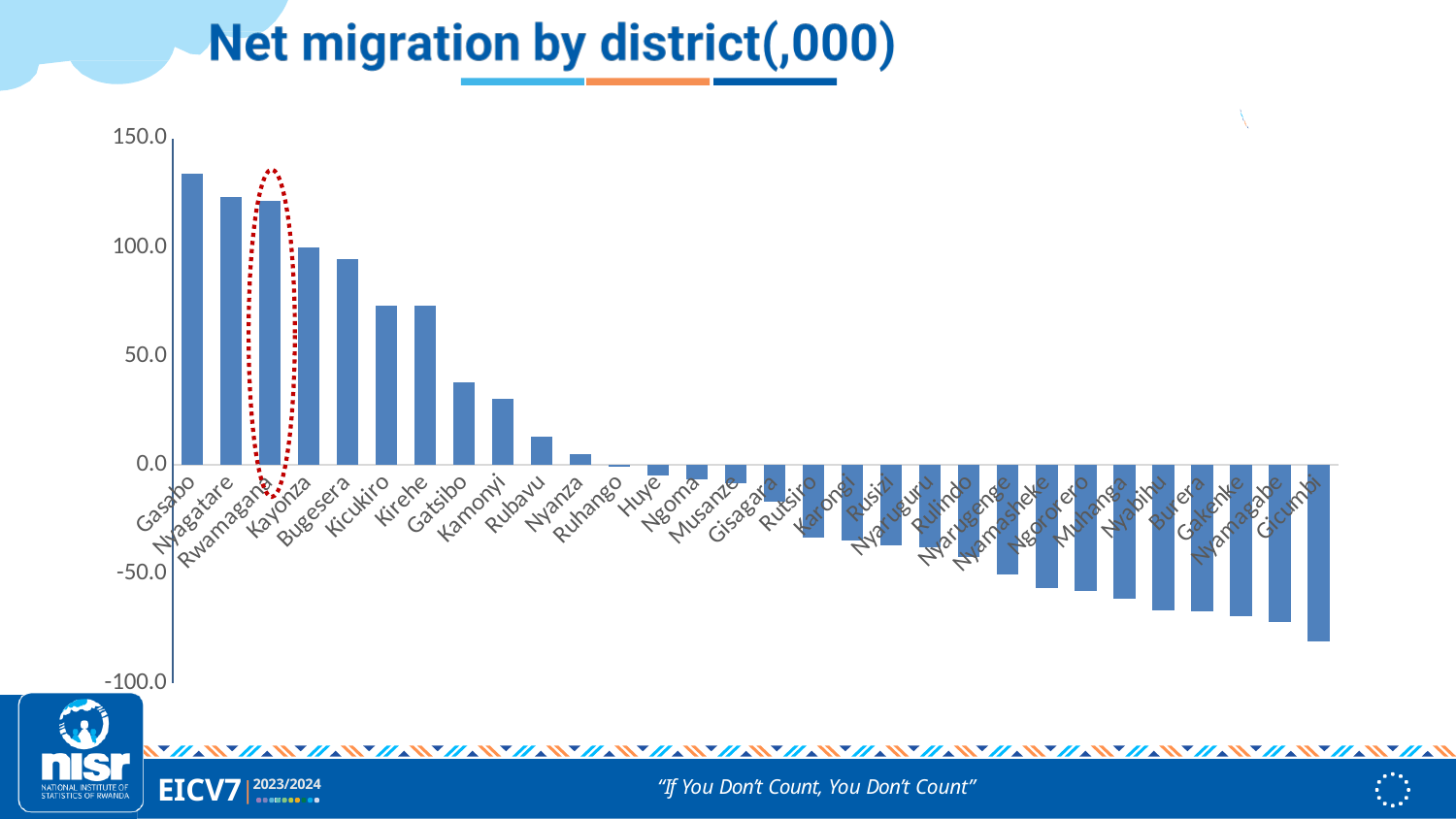
Do the values rise or fall moving from left to right along the x axis? fall How many districts are plotted in the chart? 30 Is the value for Bugesera greater or less than 100.0? less Which district has the lowest net migration? Gicumbi Which district has the highest net migration? Gasabo What is the title of the chart? Net migration by district(,000) Is the value for Gicumbi greater or less than -50.0? less What kind of chart is shown on the slide? bar chart Which has the larger net migration, Gasabo or Nyagatare? Gasabo Is the value for Gasabo greater or less than 100.0? greater